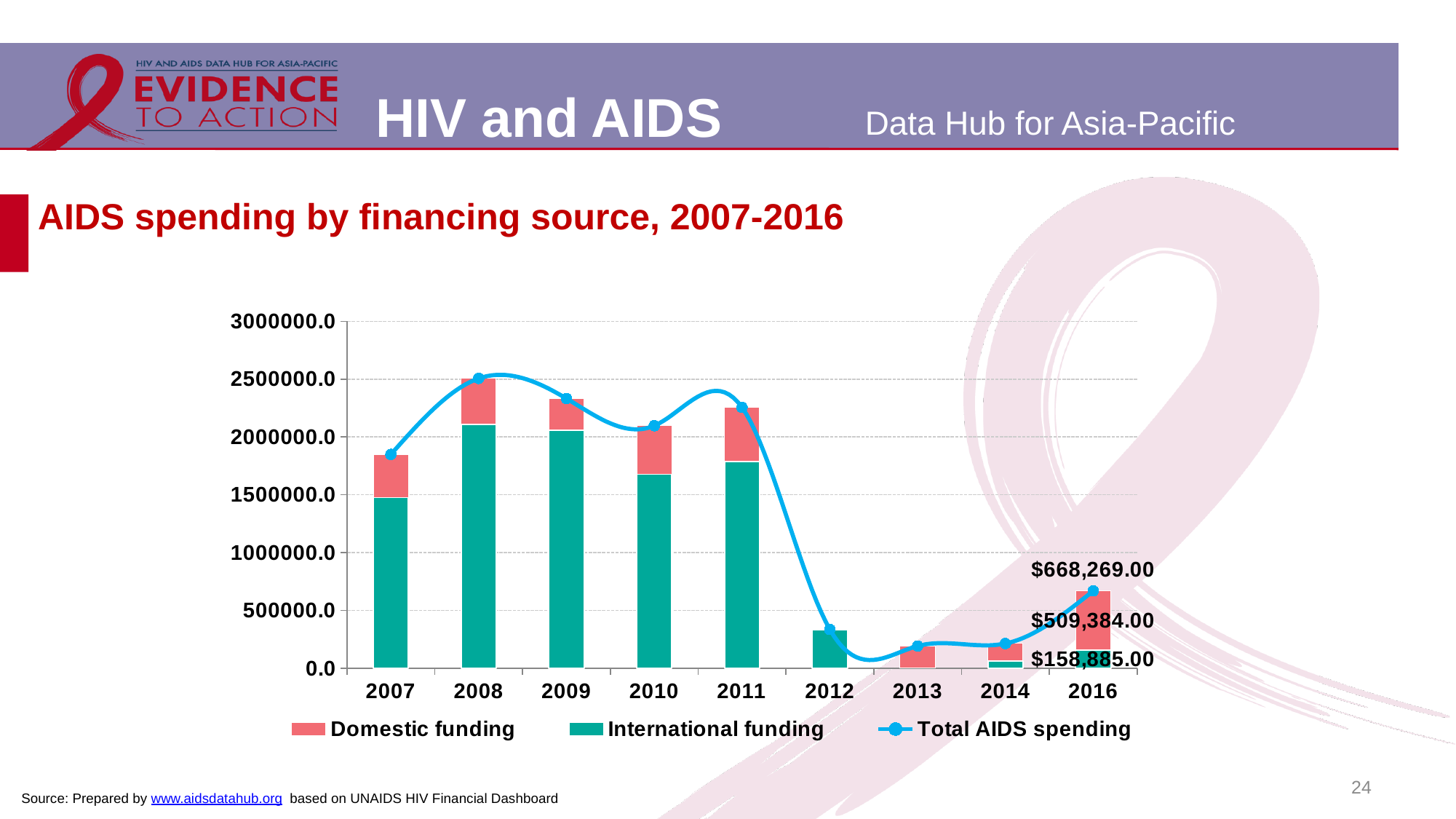
Which year has the larger Total AIDS spending, 2011 or 2012? 2011 Does Total AIDS spending rise or fall between 2011 and 2012? fall Is the Total AIDS spending for 2012 greater or less than 500000.0? less How many years are shown on the x axis of the chart? 9 What is the Total AIDS spending value shown for 2016? $668,269.00 Which year has the highest Total AIDS spending? 2008 What is the International funding value labelled for 2016? $158,885.00 In 2016, how much larger is Domestic funding than International funding? $350,499.00 What is the Domestic funding value labelled for 2016? $509,384.00 How many series does the chart legend list? 3 Which series in the legend is shown as a blue line with markers? Total AIDS spending Is the Total AIDS spending for 2007 greater or less than 1500000.0? greater